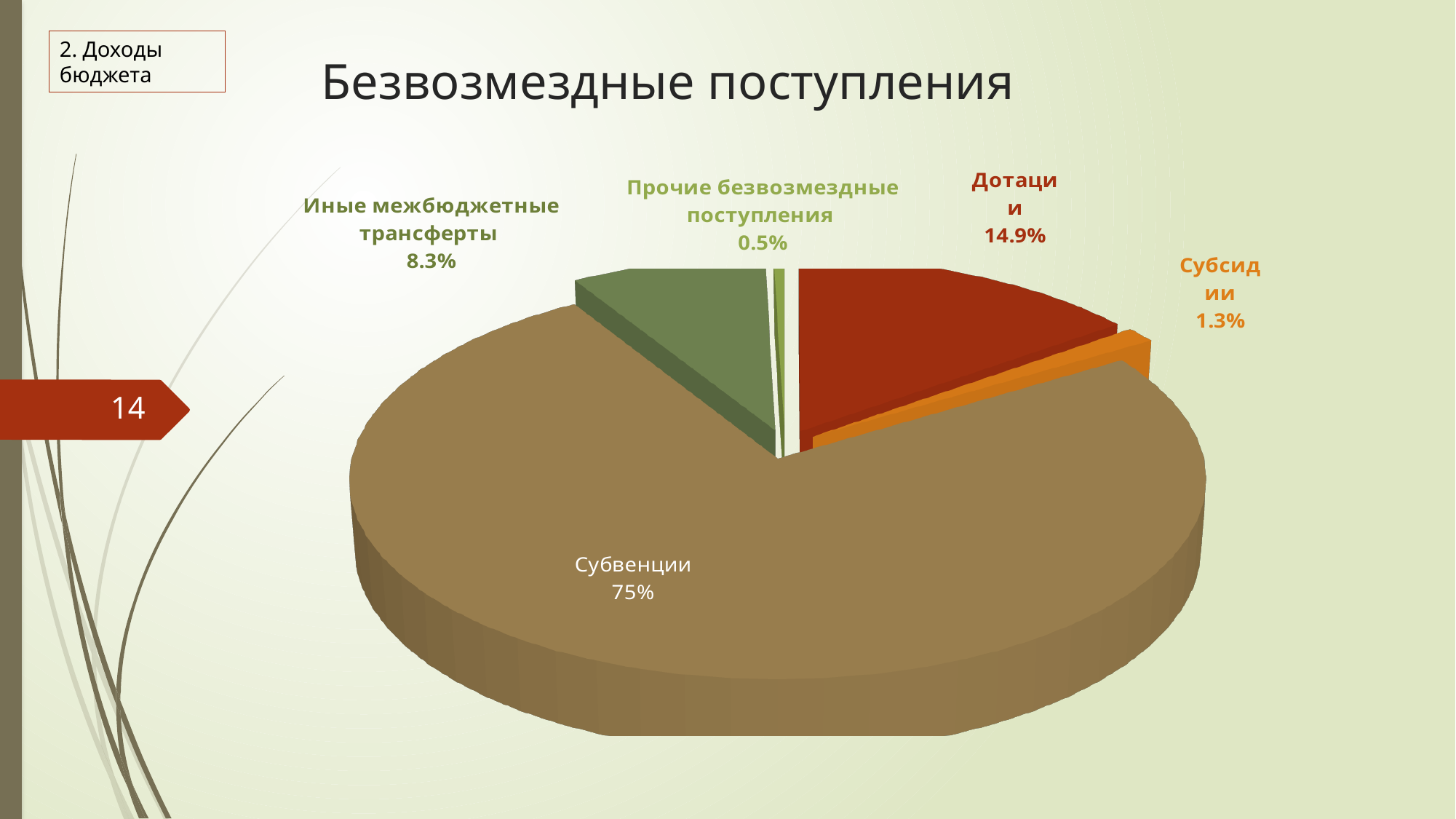
What is the value shown for Дотации? 14.9% How many categories are shown in the pie chart? 5 Which category has the smallest slice of the pie? Прочие безвозмездные поступления What is the value shown for Прочие безвозмездные поступления? 0.5% What is the difference between the values for Дотации and Иные межбюджетные трансферты? 6.6% What share of the pie does Субвенции hold? 75% What is the title of the chart? Безвозмездные поступления Which category has the largest slice of the pie? Субвенции What is the value shown for Иные межбюджетные трансферты? 8.3% What is the value shown for Субсидии? 1.3% What kind of chart is shown on the slide? Pie chart Which is larger, the value for Субсидии or the value for Прочие безвозмездные поступления? Субсидии